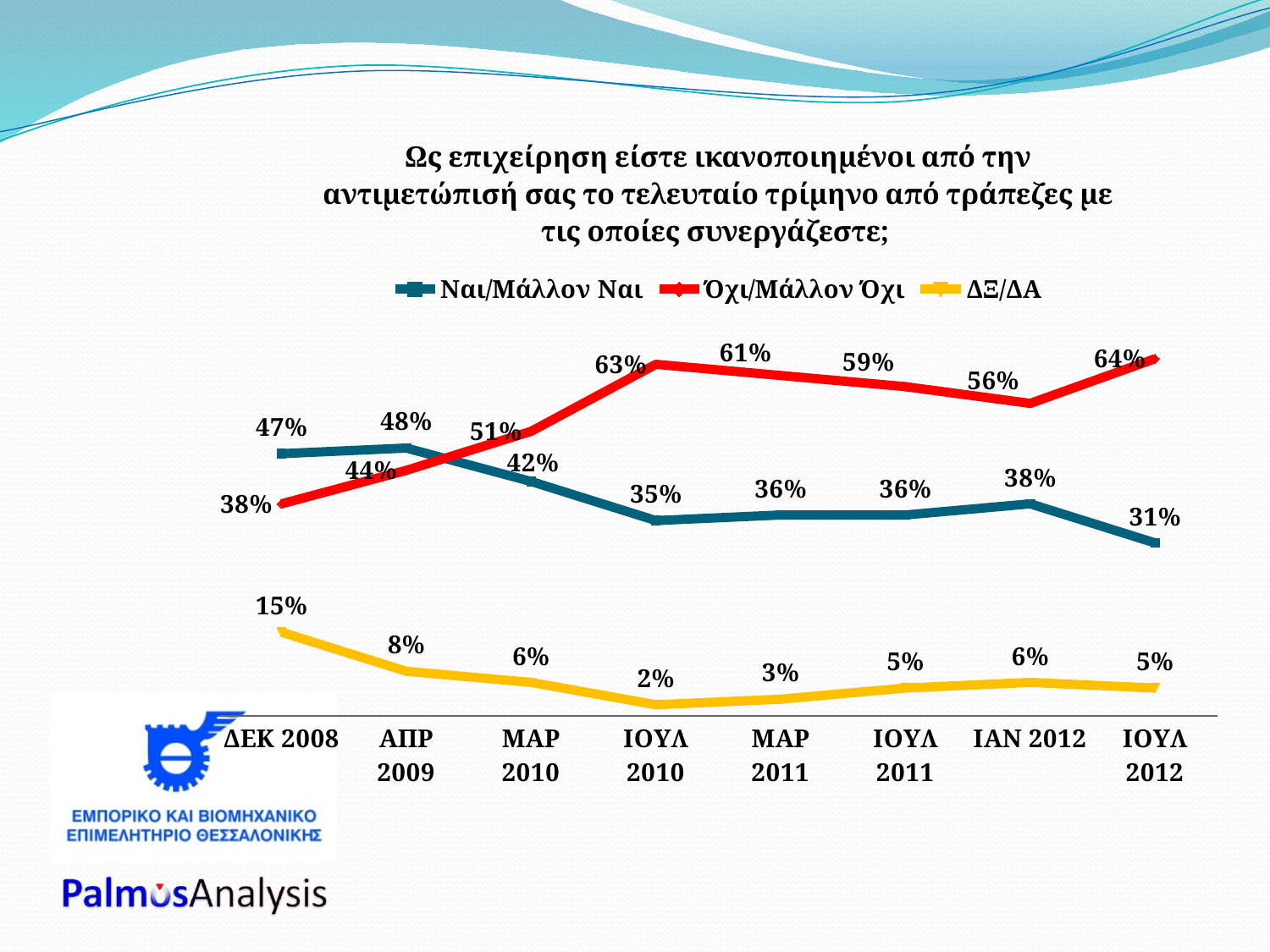
How many time points are shown on the x axis? 8 Which series has the higher value in ΔΕΚ 2008, Ναι/Μάλλον Ναι or Όχι/Μάλλον Όχι? Ναι/Μάλλον Ναι What is the difference between Όχι/Μάλλον Όχι and Ναι/Μάλλον Ναι in ΙΟΥΛ 2010? 28% In which period is ΔΞ/ΔΑ at its highest? ΔΕΚ 2008 What is the value of ΔΞ/ΔΑ in ΙΟΥΛ 2010? 2% What kind of chart is shown on the slide? Line chart How many series does the legend list? 3 What is the value of Όχι/Μάλλον Όχι in ΙΟΥΛ 2012? 64% Does the Όχι/Μάλλον Όχι series rise or fall from ΔΕΚ 2008 to ΙΟΥΛ 2010? Rise Which colour is used for the ΔΞ/ΔΑ series? Yellow What is the value of Ναι/Μάλλον Ναι in ΑΠΡ 2009? 48% In which period is Ναι/Μάλλον Ναι at its lowest? ΙΟΥΛ 2012